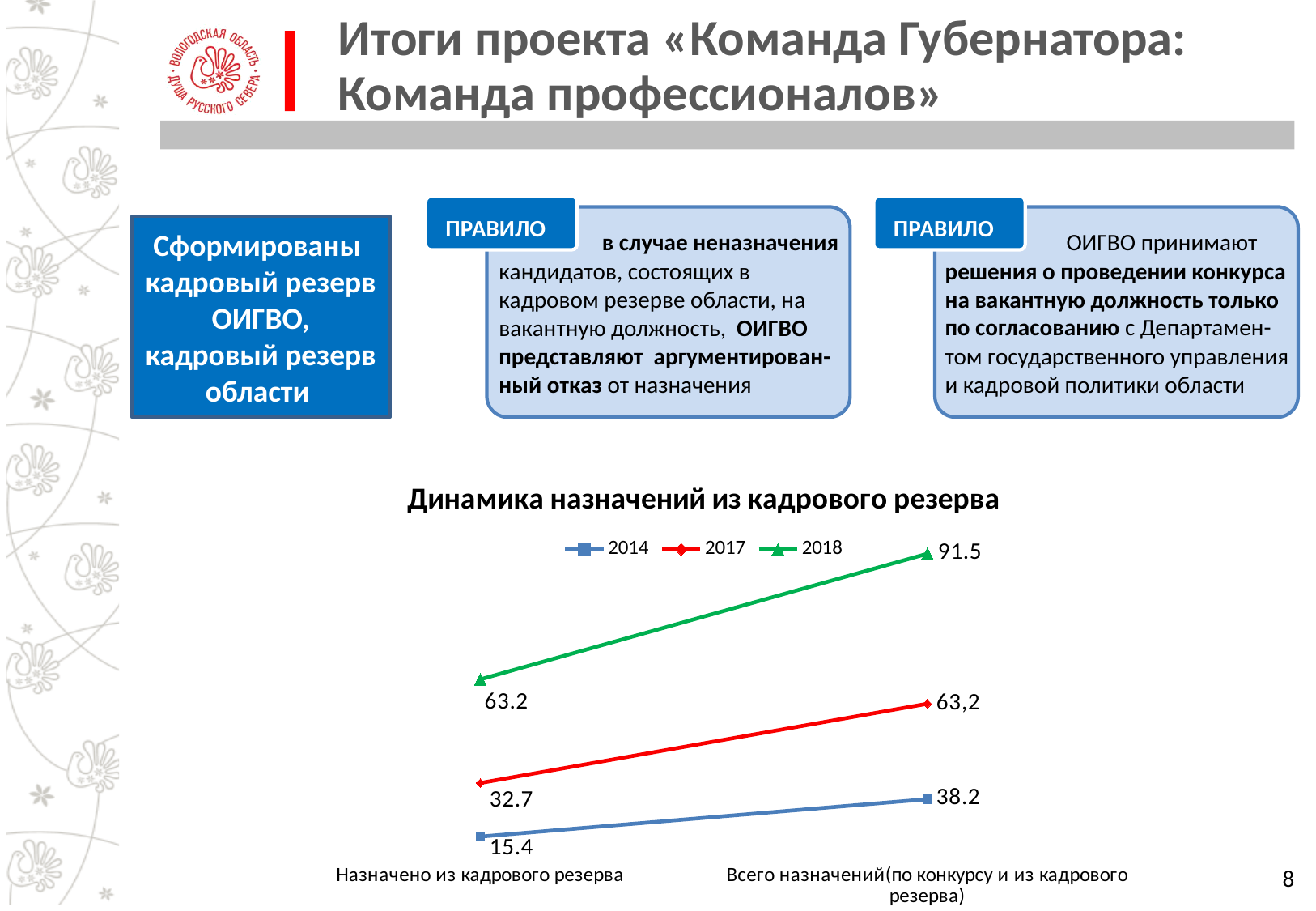
What is the value of the 2018 series for "Всего назначений(по конкурсу и из кадрового резерва)"? 91.5 What is the value of the 2014 series for "Назначено из кадрового резерва"? 15.4 Does the 2018 series rise or fall from "Назначено из кадрового резерва" to "Всего назначений(по конкурсу и из кадрового резерва)"? rise What kind of chart is shown on the slide? line chart How many categories are shown on the x axis of the chart? 2 What is the title of the chart? Динамика назначений из кадрового резерва What is the value of the 2017 series for "Назначено из кадрового резерва"? 32.7 Which series has the highest value for "Назначено из кадрового резерва"? 2018 Which series has the lowest value for "Всего назначений(по конкурсу и из кадрового резерва)"? 2014 What is the difference between the 2018 and 2014 values for "Назначено из кадрового резерва"? 47.8 How many series does the chart legend list? 3 What is the value of the 2014 series for "Всего назначений(по конкурсу и из кадрового резерва)"? 38.2